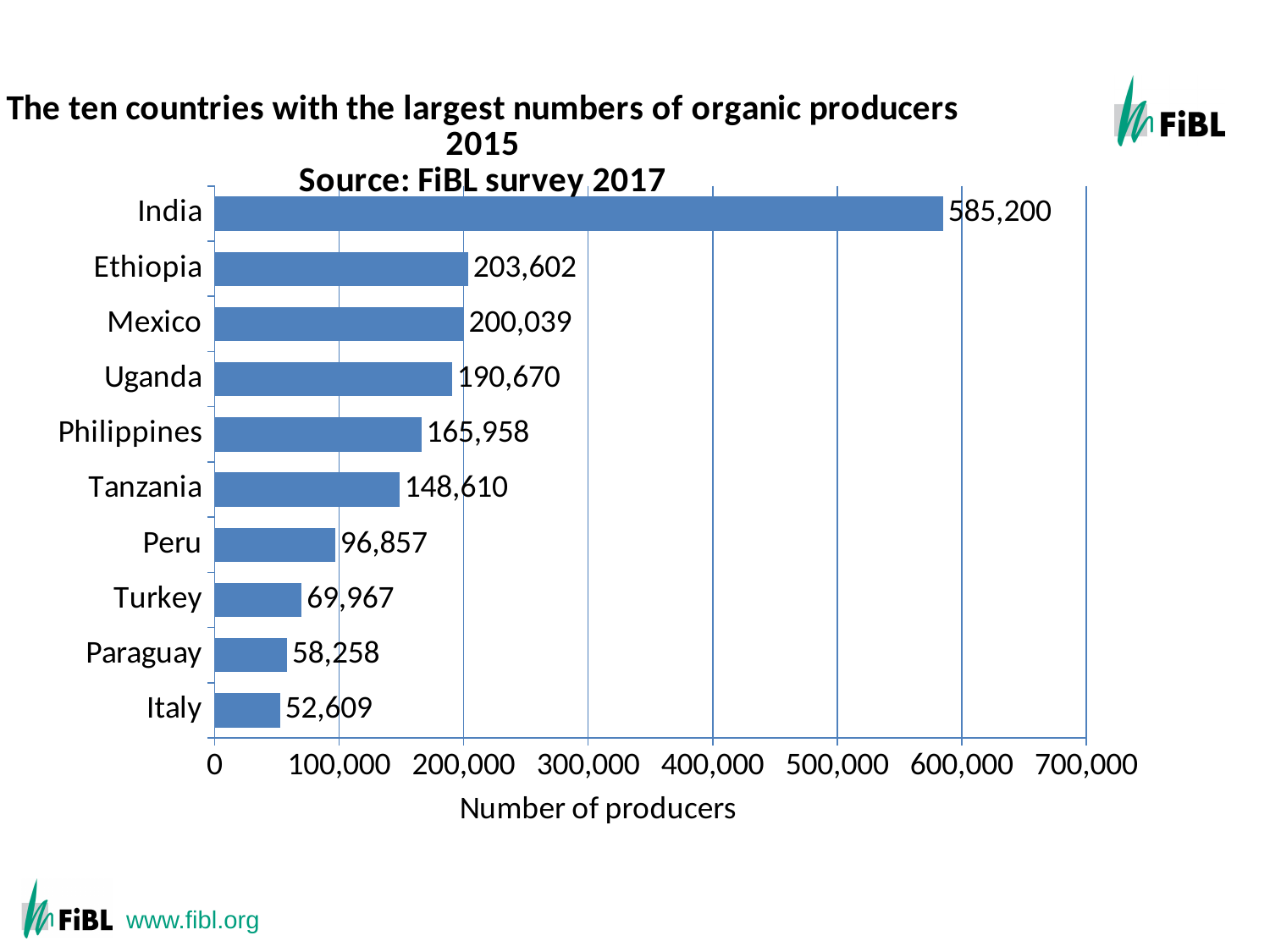
What is the label of the horizontal axis? Number of producers What is the number of organic producers for Uganda? 190,670 How many countries are shown in the chart? 10 What is the number of organic producers for India? 585,200 Which country has the largest number of organic producers? India Is the value for Paraguay greater or less than 100,000? less What is the difference in the number of organic producers between Ethiopia and Mexico? 3,563 Which country has the smallest number of organic producers among those shown? Italy What is the difference in the number of organic producers between India and Tanzania? 436,590 What kind of chart is shown on the slide? Bar chart What is the number of organic producers for Peru? 96,857 Which has more organic producers, the Philippines or Turkey? Philippines